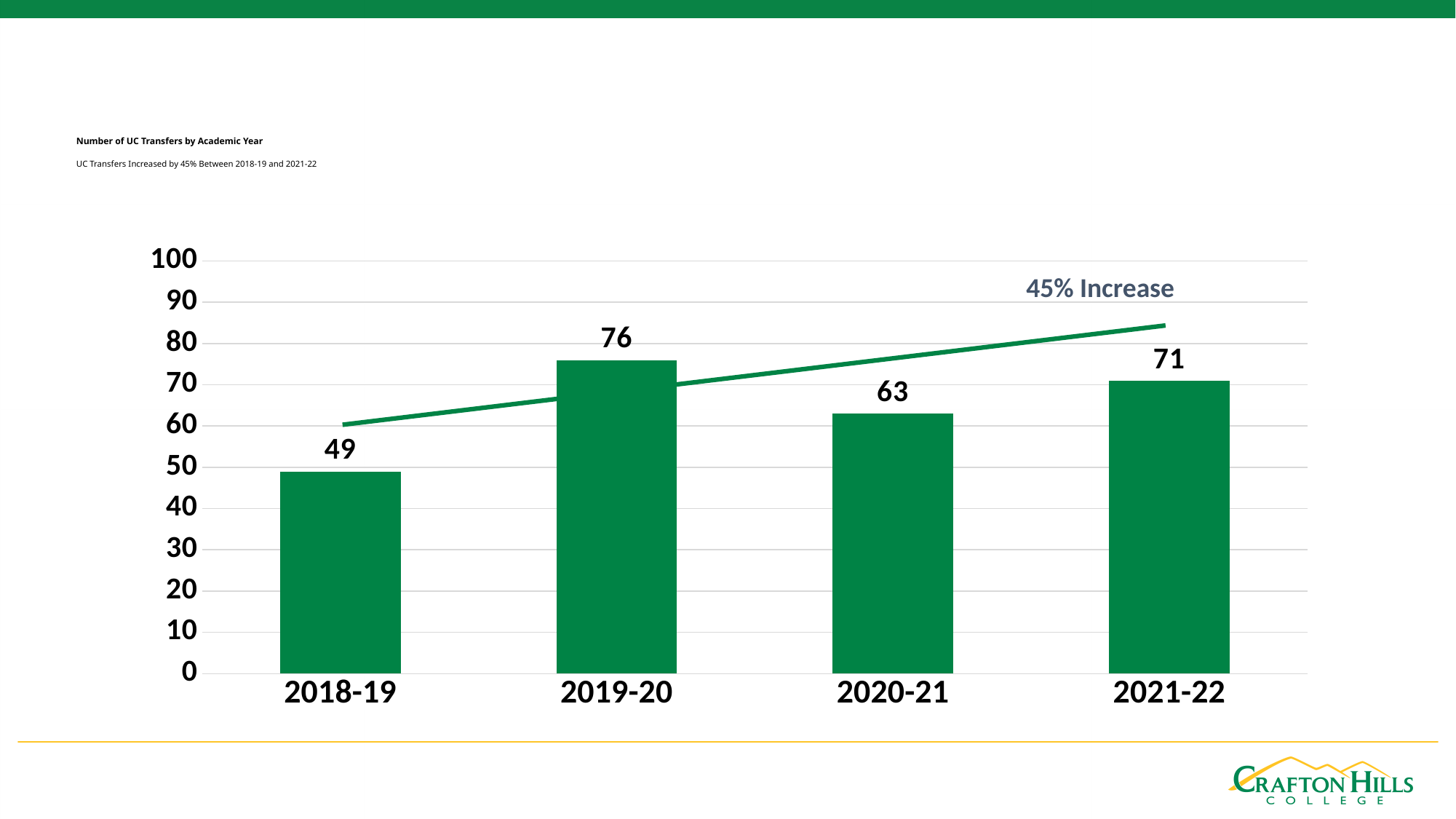
What is the difference in UC transfers between 2019-20 and 2018-19? 27 What is the number of UC transfers in 2018-19? 49 What is the number of UC transfers in 2020-21? 63 What percentage increase does the annotation on the chart state? 45% Increase How many academic years are shown in the chart? 4 Which academic year has the lowest number of UC transfers? 2018-19 Which year had more UC transfers, 2020-21 or 2021-22? 2021-22 Which academic year has the highest number of UC transfers? 2019-20 What is the number of UC transfers in 2021-22? 71 What is the difference in UC transfers between 2021-22 and 2020-21? 8 What is the number of UC transfers in 2019-20? 76 What kind of chart is shown on the slide? Bar chart